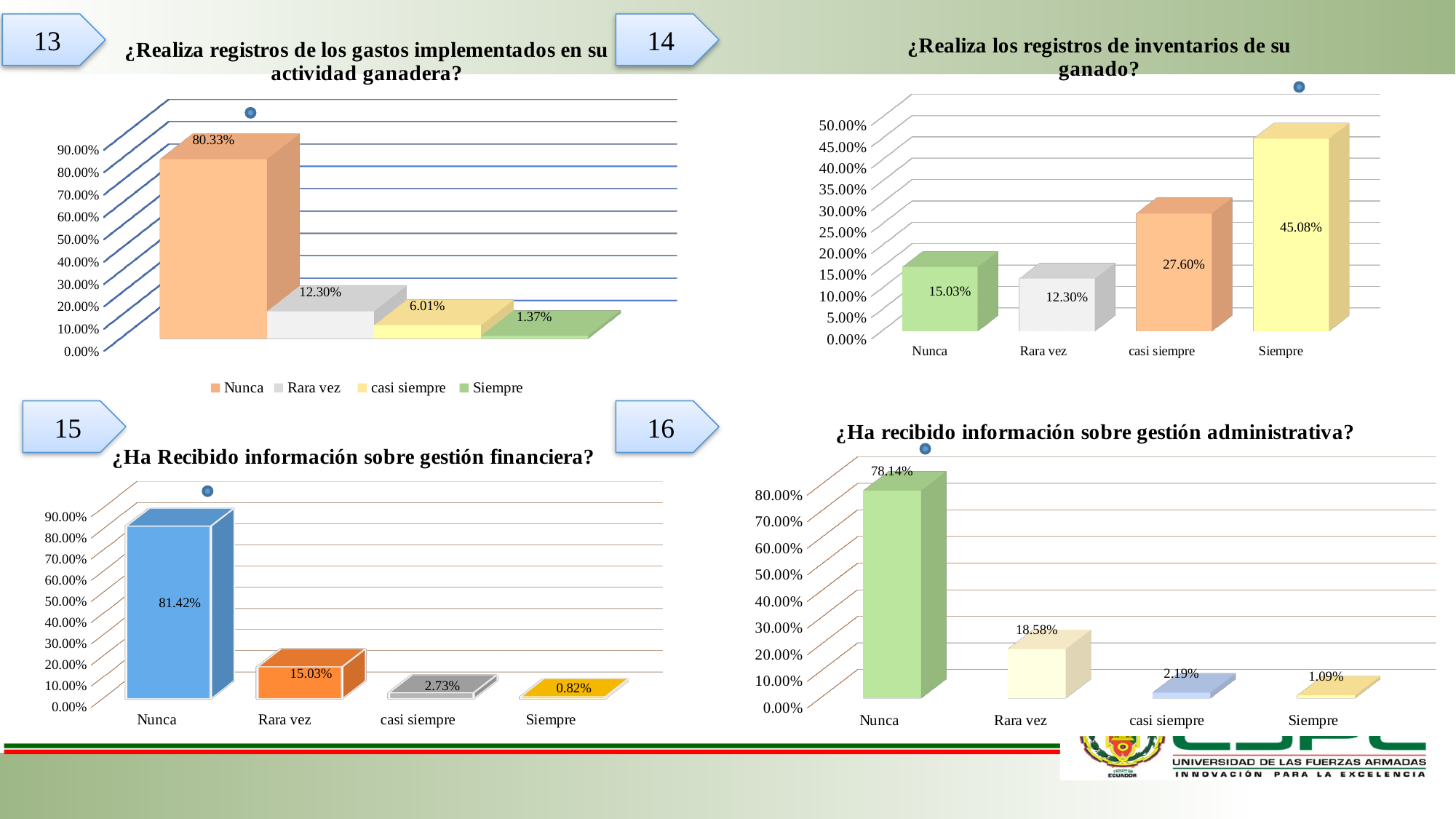
In the chart titled '¿Ha recibido información sobre gestión administrativa?', which is larger, the value for Rara vez or the value for casi siempre? Rara vez In the chart titled '¿Realiza los registros de inventarios de su ganado?', which category has the lowest value? Rara vez In the chart titled '¿Ha Recibido información sobre gestión financiera?', what is the value for Rara vez? 15.03% In the chart titled '¿Ha recibido información sobre gestión administrativa?', what is the value for Siempre? 1.09% In the chart titled '¿Realiza los registros de inventarios de su ganado?', what is the value for casi siempre? 27.60% In the chart titled '¿Ha recibido información sobre gestión administrativa?', do the values rise or fall from Nunca to Siempre along the x axis? Fall In the chart titled '¿Ha Recibido información sobre gestión financiera?', what kind of chart is it? Bar chart In the chart titled '¿Realiza los registros de inventarios de su ganado?', which category has the highest value? Siempre In the chart titled '¿Realiza registros de los gastos implementados en su actividad ganadera?', how many entries does the legend list? 4 In the chart titled '¿Realiza los registros de inventarios de su ganado?', what is the difference between the values for Siempre and Nunca? 30.05% In the chart titled '¿Realiza registros de los gastos implementados en su actividad ganadera?', what is the value for Nunca? 80.33% In the chart titled '¿Ha Recibido información sobre gestión financiera?', how many categories are shown on the x axis? 4